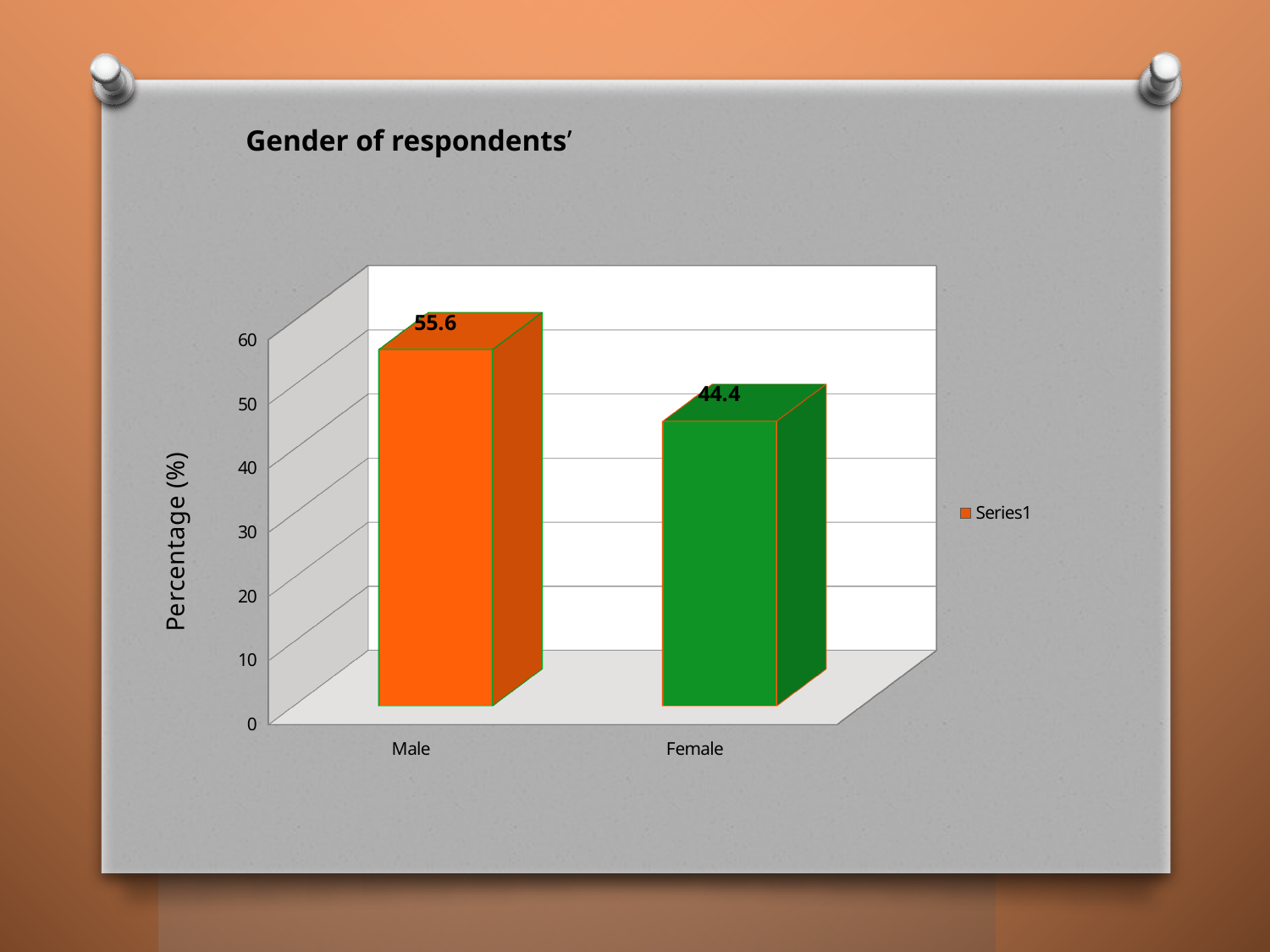
Which category has the highest value? Male How many series does the legend list? 1 What is the label of the vertical axis? Percentage (%) What is the value for Female? 44.4 Is the value for Female greater or less than 50? less What kind of chart is shown on the slide? bar chart Which is larger, the value for Male or the value for Female? Male Which category has the lowest value? Female What is the value for Male? 55.6 How many categories are shown on the x axis? 2 Is the value for Male greater or less than 50? greater What is the difference between the values for Male and Female? 11.2